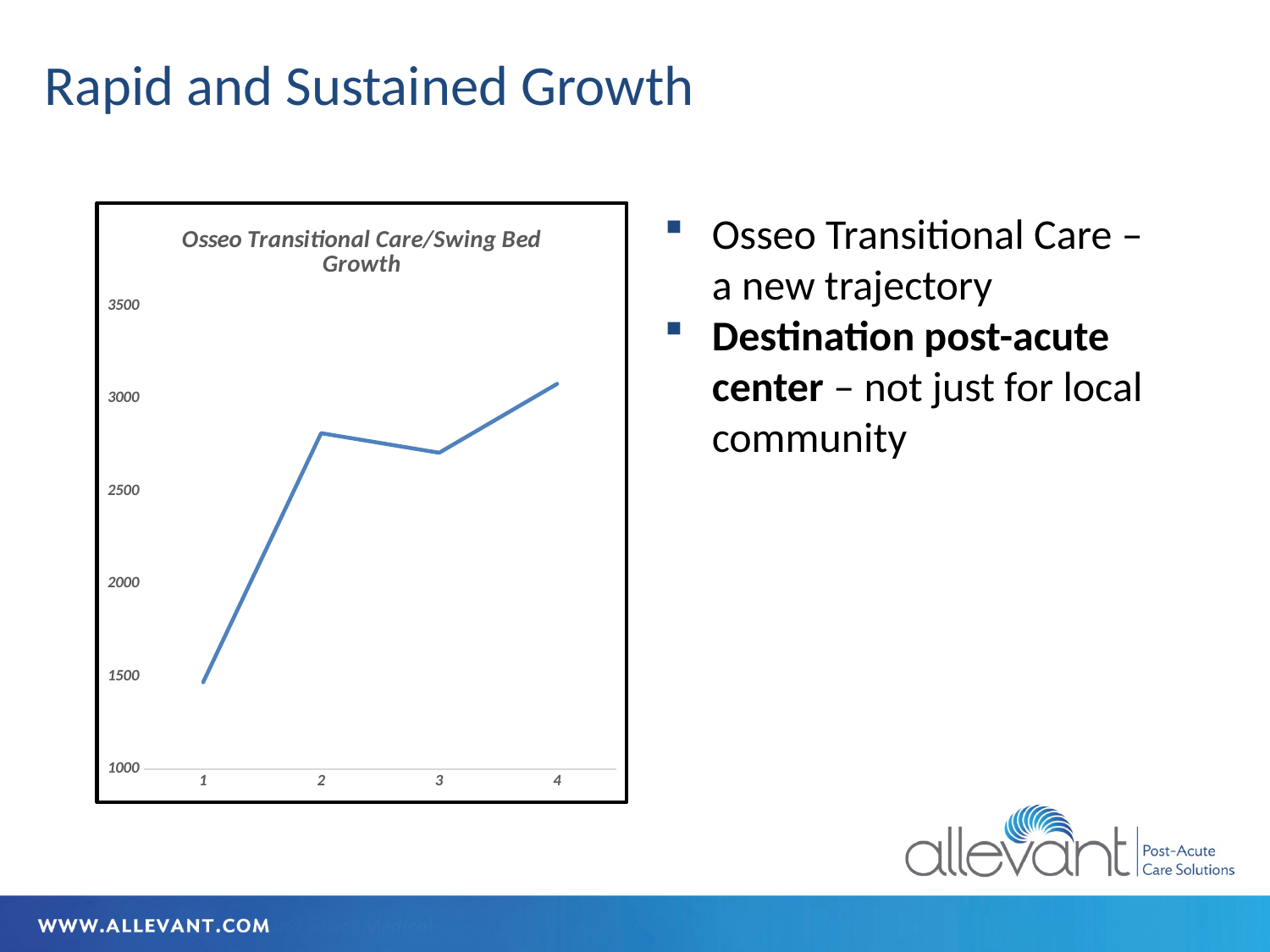
Is the value at point 2 greater or less than 2500? greater How many points are plotted on the line? 4 Which is larger, the value at point 3 or the value at point 4? point 4 Which is larger, the value at point 1 or the value at point 2? point 2 What is the title of the chart? Osseo Transitional Care/Swing Bed Growth Is the value at point 4 greater or less than 3000? greater What kind of chart is shown on the slide? line chart Overall, do the values rise or fall from point 1 to point 4? rise Which x-axis category has the highest value? 4 Which x-axis category has the lowest value? 1 Is the value at point 3 greater or less than 3000? less